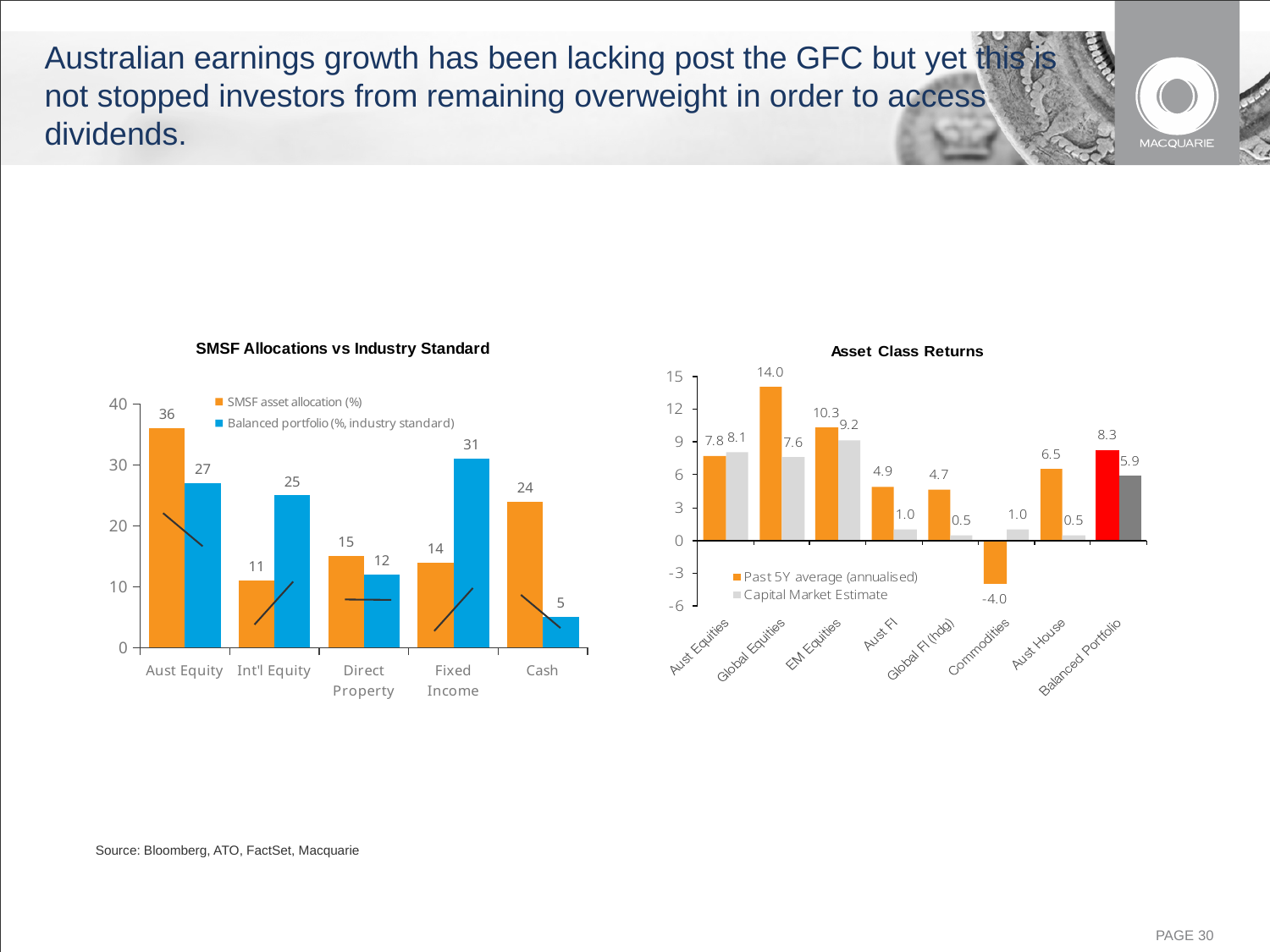
In the 'SMSF Allocations vs Industry Standard' chart, what is the difference between the SMSF asset allocation and the Balanced portfolio value for Cash? 19 In the 'Asset Class Returns' chart, what is the difference between the Past 5Y average (annualised) and the Capital Market Estimate for EM Equities? 1.1 In the 'SMSF Allocations vs Industry Standard' chart, is the SMSF asset allocation or the Balanced portfolio value larger for Int'l Equity? Balanced portfolio In the 'Asset Class Returns' chart, which category has the lowest Past 5Y average (annualised)? Commodities In the 'Asset Class Returns' chart, what is the Capital Market Estimate for Balanced Portfolio? 5.9 In the 'SMSF Allocations vs Industry Standard' chart, what is the SMSF asset allocation for Aust Equity? 36 In the 'Asset Class Returns' chart, what is the Past 5Y average (annualised) for Global Equities? 14.0 In the 'SMSF Allocations vs Industry Standard' chart, which category has the lowest Balanced portfolio value? Cash In the 'SMSF Allocations vs Industry Standard' chart, what is the Balanced portfolio value for Fixed Income? 31 In the 'Asset Class Returns' chart, how many series does the legend list? 2 In the 'SMSF Allocations vs Industry Standard' chart, how many categories are shown on the x axis? 5 What kind of chart is 'Asset Class Returns'? Bar chart